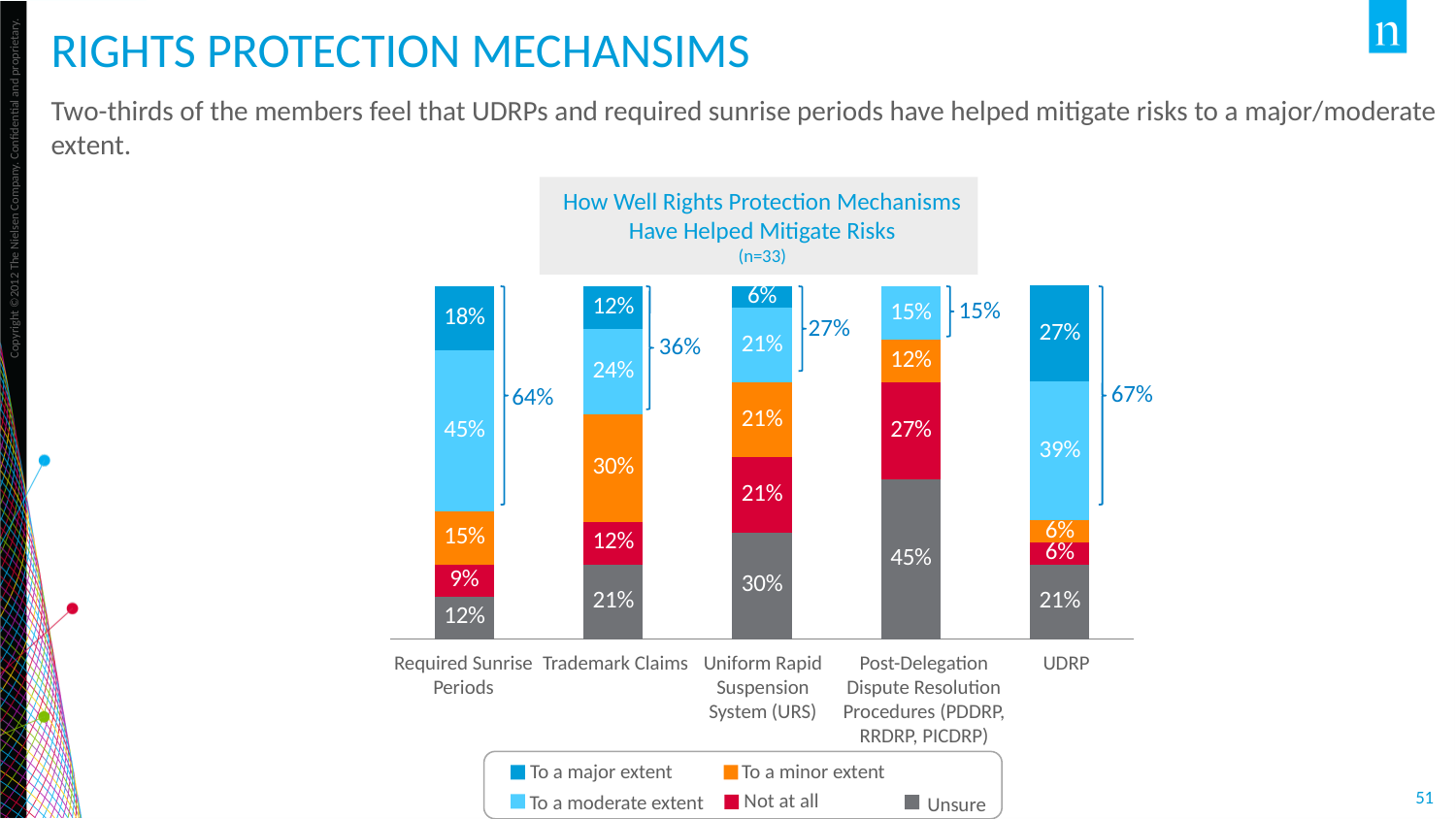
Which has a larger 'Not at all' share: Trademark Claims or UDRP? Trademark Claims What percentage of members were unsure about the Post-Delegation Dispute Resolution Procedures (PDDRP, RRDRP, PICDRP)? 45% How many response categories does the legend list? 5 Which mechanism has the highest share of members who were unsure? Post-Delegation Dispute Resolution Procedures (PDDRP, RRDRP, PICDRP) How many rights protection mechanisms are shown on the chart? 5 Which mechanism has the lowest share of members who said it helped to a major extent, among those with a major-extent segment shown? Uniform Rapid Suspension System (URS) What percentage of members said Trademark Claims helped to a minor extent? 30% What percentage of members said the Uniform Rapid Suspension System (URS) did not help at all? 21% What type of chart is used on this slide? Stacked bar chart What percentage of members said Required Sunrise Periods helped to a moderate extent? 45% What percentage of members said UDRP helped mitigate risks to a major extent? 27% What is the difference in the 'Unsure' share between the Post-Delegation Dispute Resolution Procedures and Required Sunrise Periods? 33 percentage points